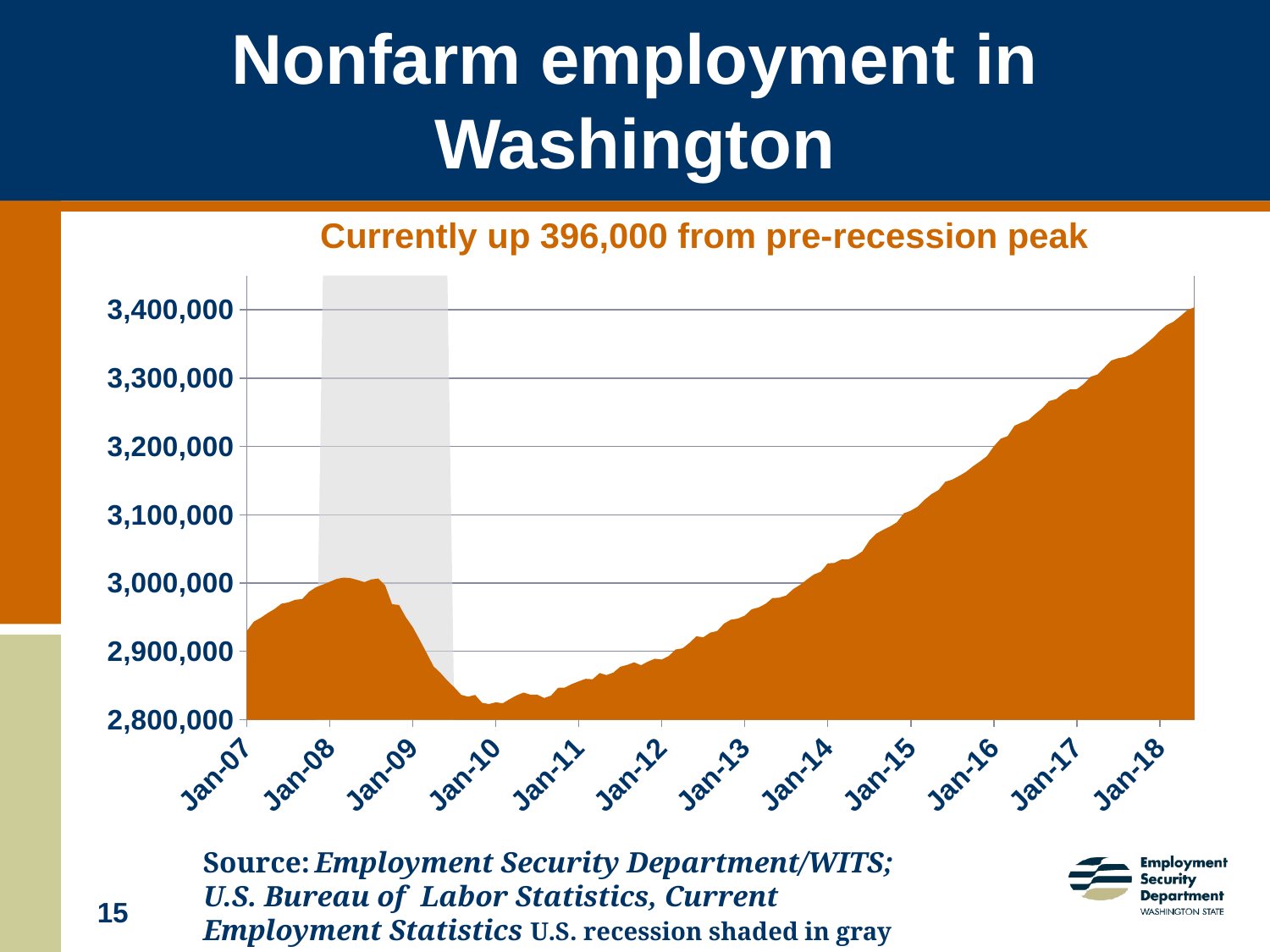
Is the value at Jan-08 greater or less than 2,900,000? greater What is the title of the chart on the slide? Nonfarm employment in Washington Which is larger, the value at Jan-08 or the value at Jan-10? Jan-08 Is the value at Jan-11 greater or less than 2,900,000? less Is the value at Jan-13 greater or less than 3,000,000? less What kind of chart is shown on the slide? Area chart According to the subtitle, how far above the pre-recession peak is employment currently? 396,000 Which is larger, the value at Jan-18 or the value at Jan-07? Jan-18 Does nonfarm employment rise or fall between Jan-10 and Jan-18? Rise How many year labels are shown on the x axis? 12